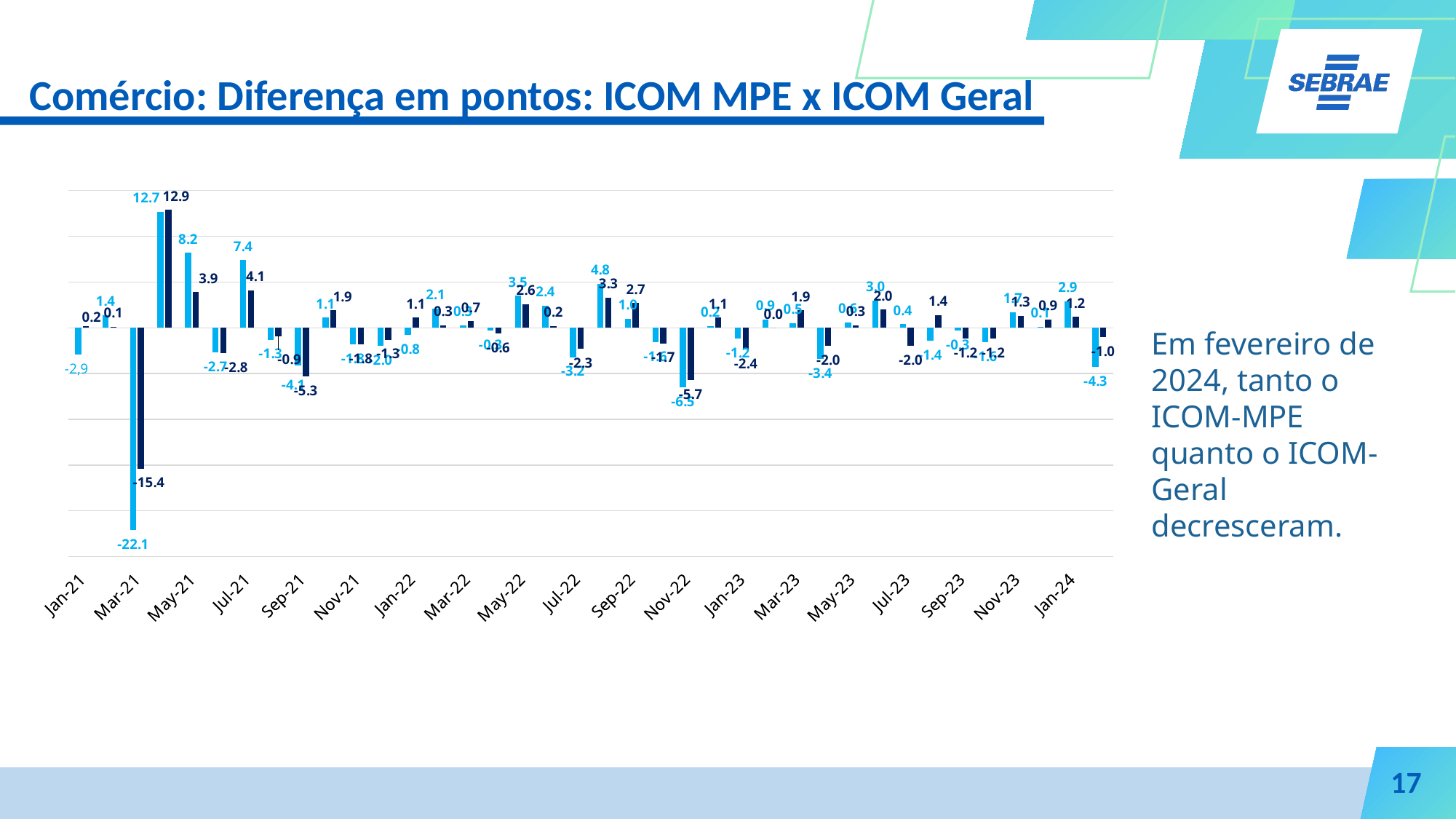
How many month labels are shown on the x axis? 19 What is the highest value labelled on the chart? 12.9 What is the value of the dark blue bar at Jul-21? 4.1 What is the lowest value labelled on the chart? -22.1 At Mar-21, which bar is lower, the light blue or the dark blue one? light blue What is the value of the light blue bar at Jul-21? 7.4 What is the value of the dark blue bar at Mar-21? -15.4 What kind of chart is shown on the slide? bar chart What is the title of the chart on the slide? Comércio: Diferença em pontos: ICOM MPE x ICOM Geral What is the difference between the dark blue bar (-15.4) and the light blue bar (-22.1) at Mar-21? 6.7 What is the value of the light blue bar at Mar-21? -22.1 What is the value of the light blue bar at Nov-22? -6.5